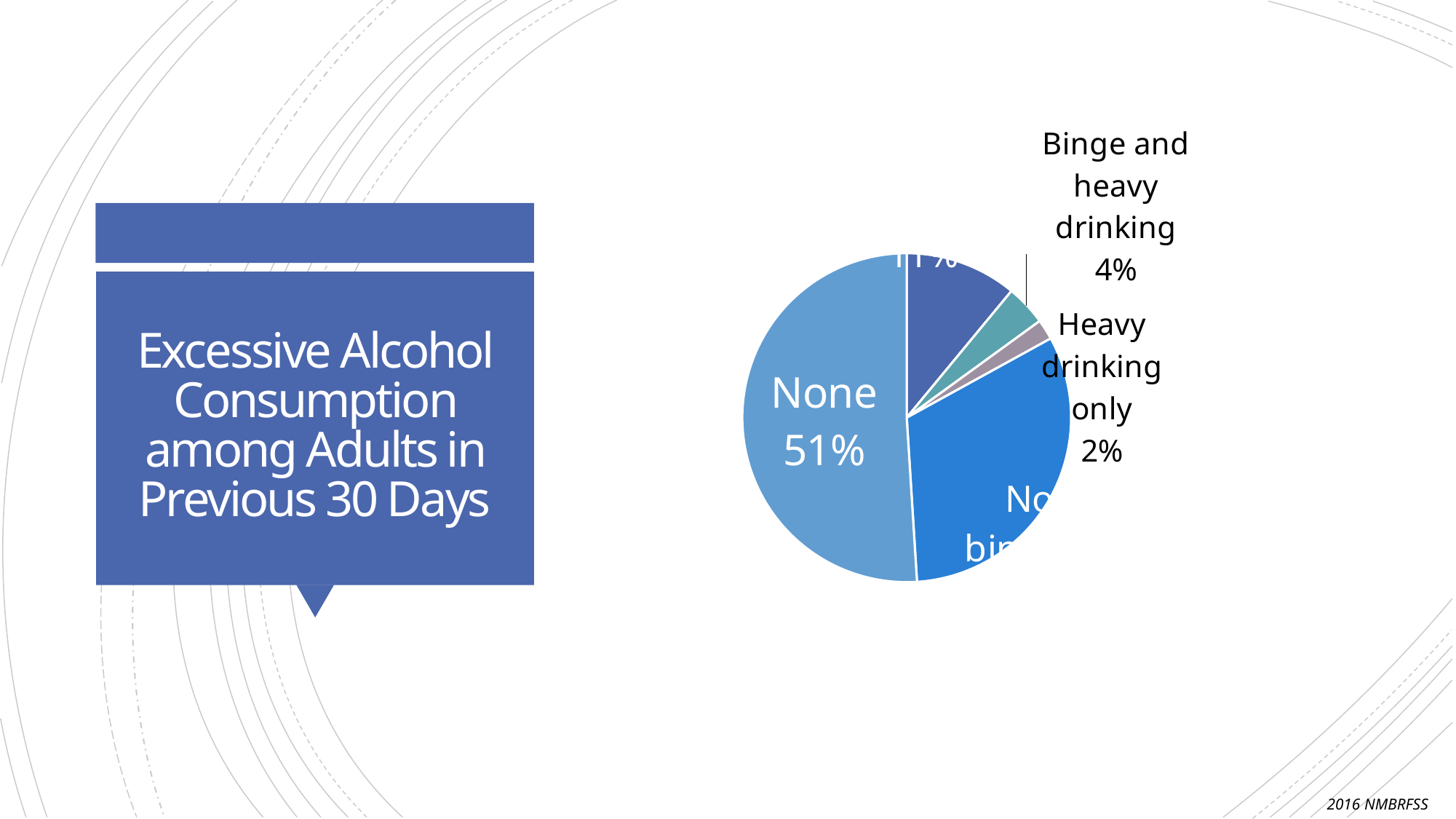
How many percentage points larger is "None" than "Binge and heavy drinking"? 47 percentage points What kind of chart is shown on the slide? pie chart What is the value shown for "Binge and heavy drinking"? 4% What is the difference between "Binge and heavy drinking" and "Heavy drinking only"? 2 percentage points What is the value shown for "Heavy drinking only"? 2% What data source is cited at the bottom right of the slide? 2016 NMBRFSS What is the title shown in the text box on the slide? Excessive Alcohol Consumption among Adults in Previous 30 Days How many slices does the pie chart have? 5 Which is larger, "Binge and heavy drinking" or "Heavy drinking only"? Binge and heavy drinking Which slice of the pie is the smallest? Heavy drinking only What share of the pie is labelled "None"? 51% Which slice of the pie is the largest? None